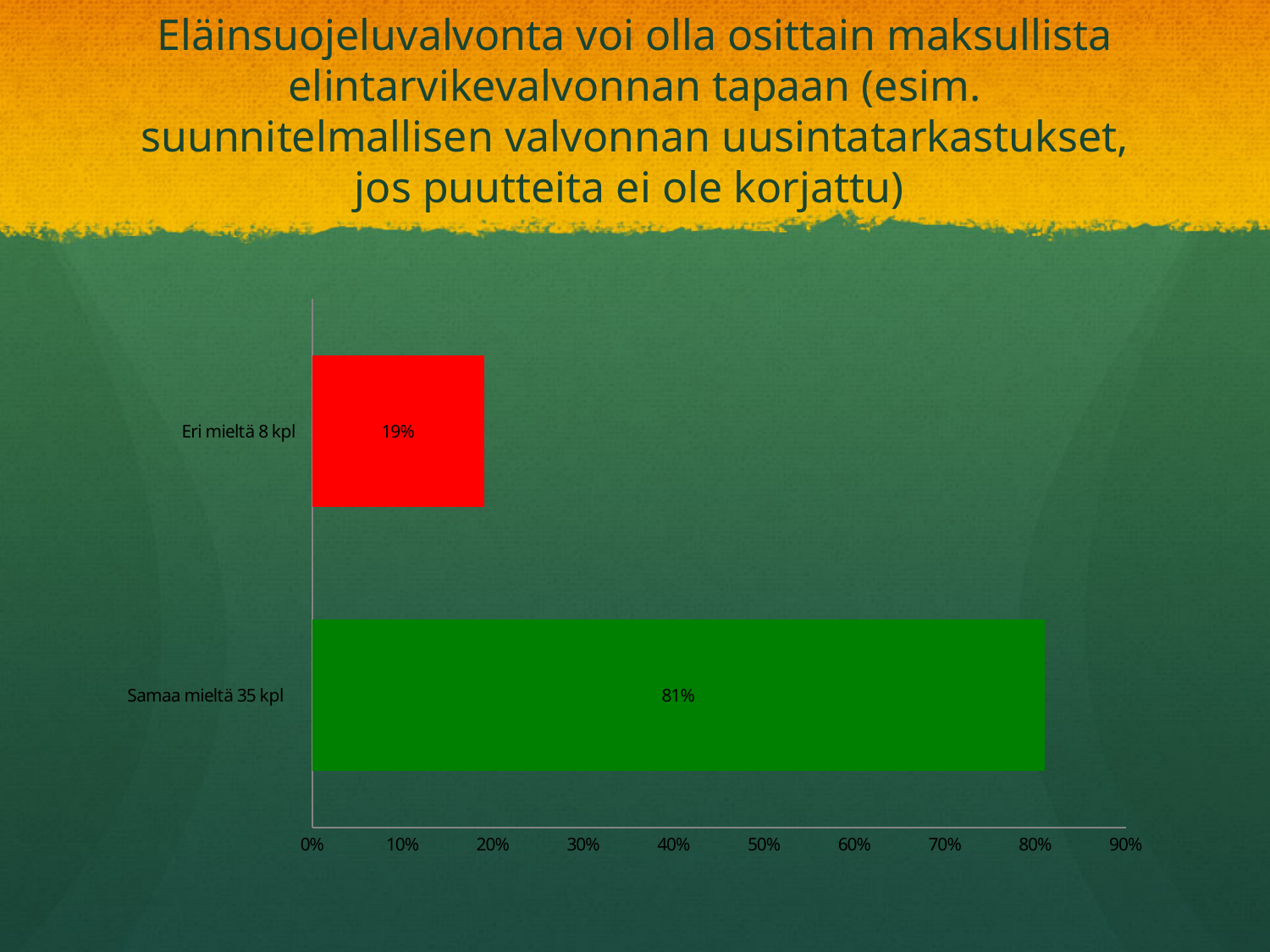
What is the value for "Eri mieltä 8 kpl"? 19% Which is larger, the value for "Eri mieltä 8 kpl" or the value for "Samaa mieltä 35 kpl"? Samaa mieltä 35 kpl Is the value for "Eri mieltä 8 kpl" greater or less than 30%? less Which category has the lowest value? Eri mieltä 8 kpl How many categories are shown in the chart? 2 Which category has the highest value? Samaa mieltä 35 kpl What is the highest value shown on the x axis? 90% What is the difference between the values for "Samaa mieltä 35 kpl" and "Eri mieltä 8 kpl"? 62% What colour is the bar for "Eri mieltä 8 kpl"? Red Is the value for "Samaa mieltä 35 kpl" greater or less than 50%? greater What is the value for "Samaa mieltä 35 kpl"? 81% What kind of chart is shown on the slide? Bar chart